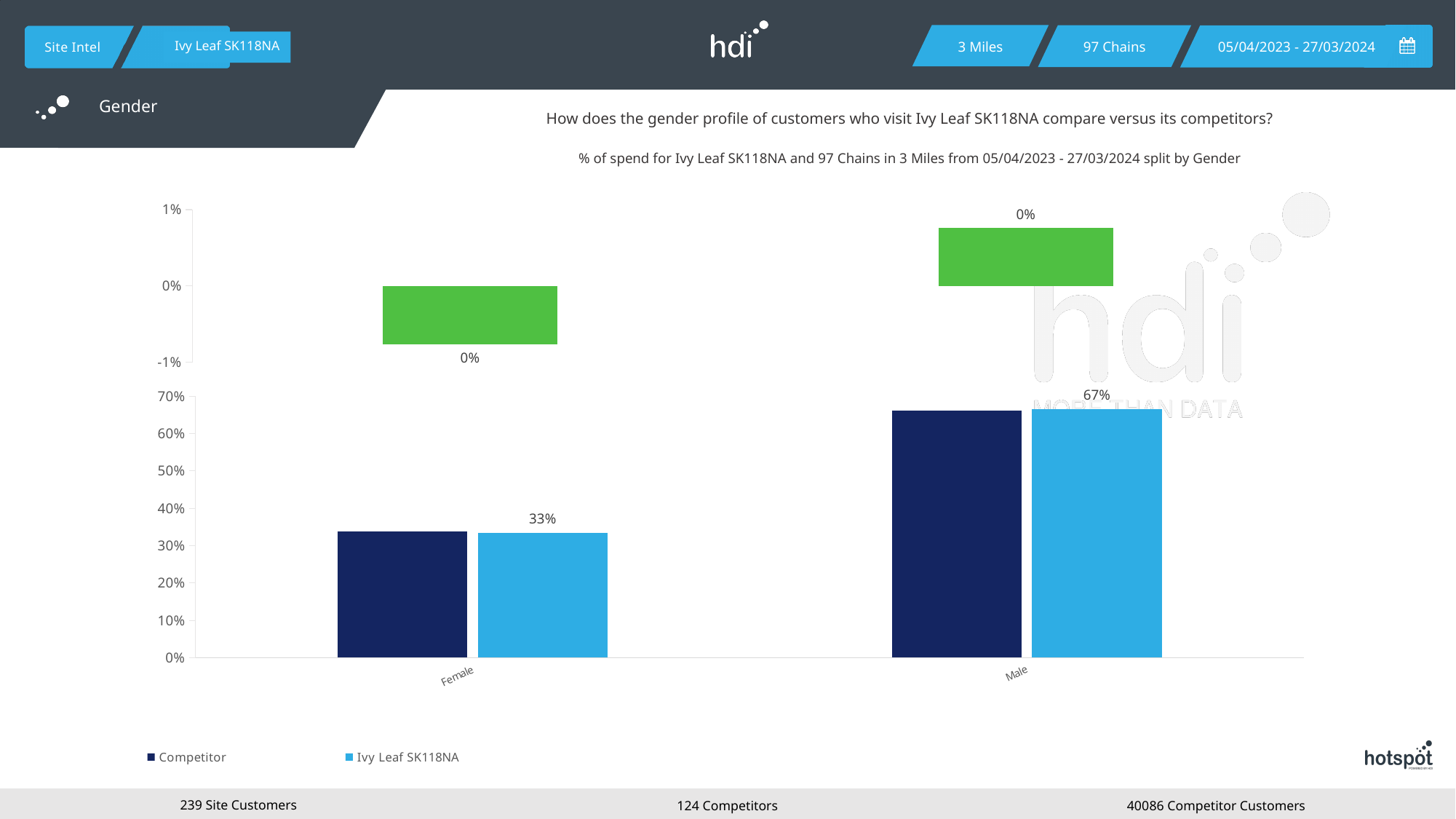
In the lower bar chart, which category has the lowest value for Ivy Leaf SK118NA? Female How many categories are shown on the x axis of the lower bar chart? 2 In the lower bar chart, is the Competitor value for Male greater or less than 60%? greater In the lower bar chart, which is larger: the Competitor value for Male or the Competitor value for Female? Male In the lower bar chart, what is the value for Ivy Leaf SK118NA in the Male category? 67% In the lower bar chart, what is the value for Ivy Leaf SK118NA in the Female category? 33% How many series does the legend of the lower bar chart list? 2 In the lower bar chart, what is the difference between the Ivy Leaf SK118NA values for Male and Female? 34% In the lower bar chart, is the Competitor value for Female greater or less than 30%? greater What kind of chart is the lower chart on the slide? bar chart In the lower bar chart, which category has the highest value for Ivy Leaf SK118NA? Male In the upper chart with green bars, what is the data label shown for the Male category? 0%